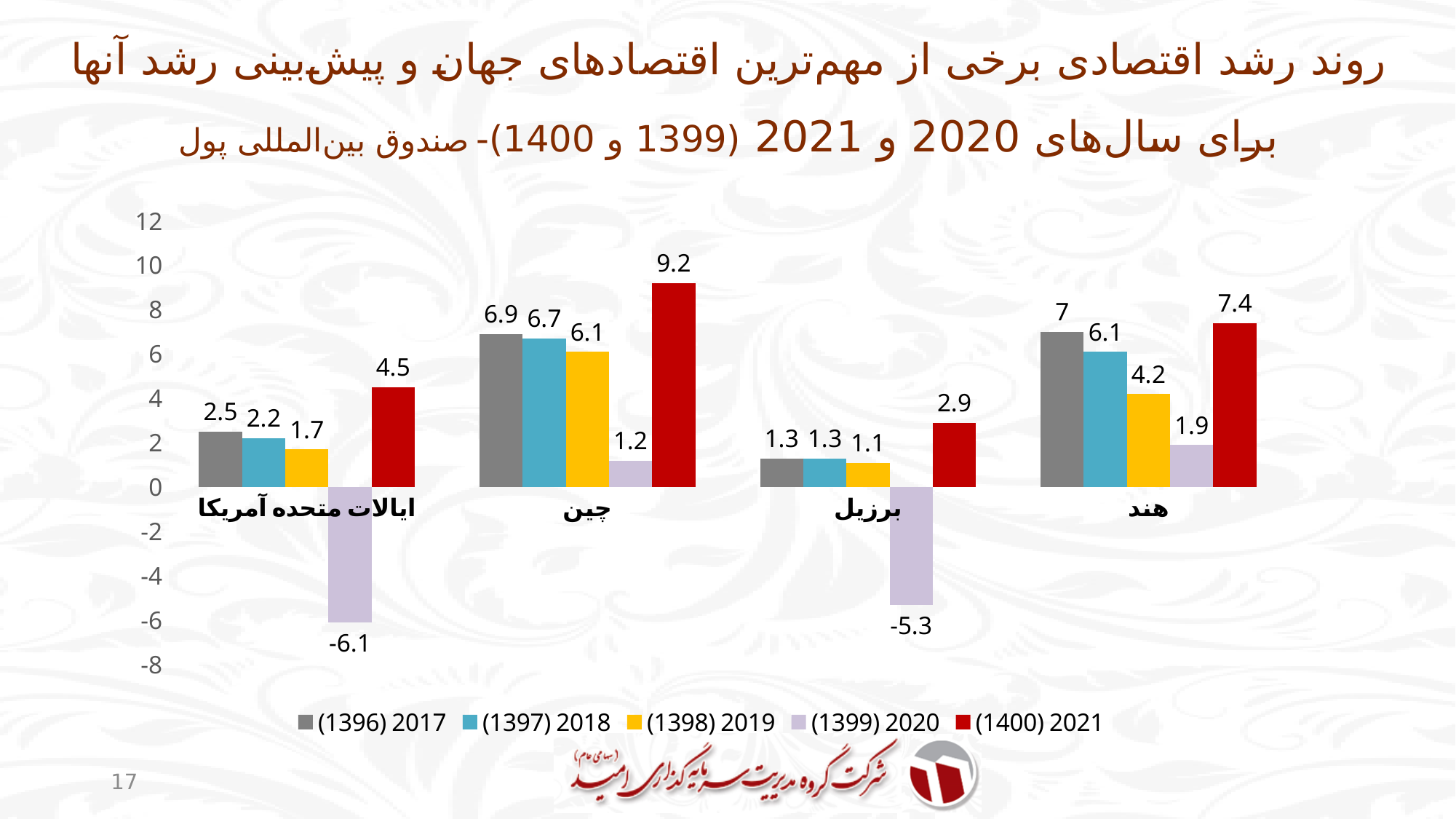
Which country has the lowest value in the (1399) 2020 series? ایالات متحده آمریکا (United States) Which colour represents the (1400) 2021 series in the legend? red What is the value for هند (India) in the (1398) 2019 series? 4.2 What is the value for چین (China) in the (1400) 2021 series? 9.2 How many series does the legend list? 5 How many countries (categories) are shown on the x axis? 4 Is the (1400) 2021 value for هند (India) greater or less than 6? greater What is the difference between the (1400) 2021 value and the (1399) 2020 value for برزیل (Brazil)? 8.2 Which is larger: the (1396) 2017 value for هند (India) or the (1396) 2017 value for چین (China)? هند (India) Which country has the highest value in the (1400) 2021 series? چین (China) What type of chart is shown on the slide? bar chart What is the value for ایالات متحده آمریکا (United States) in the (1399) 2020 series? -6.1